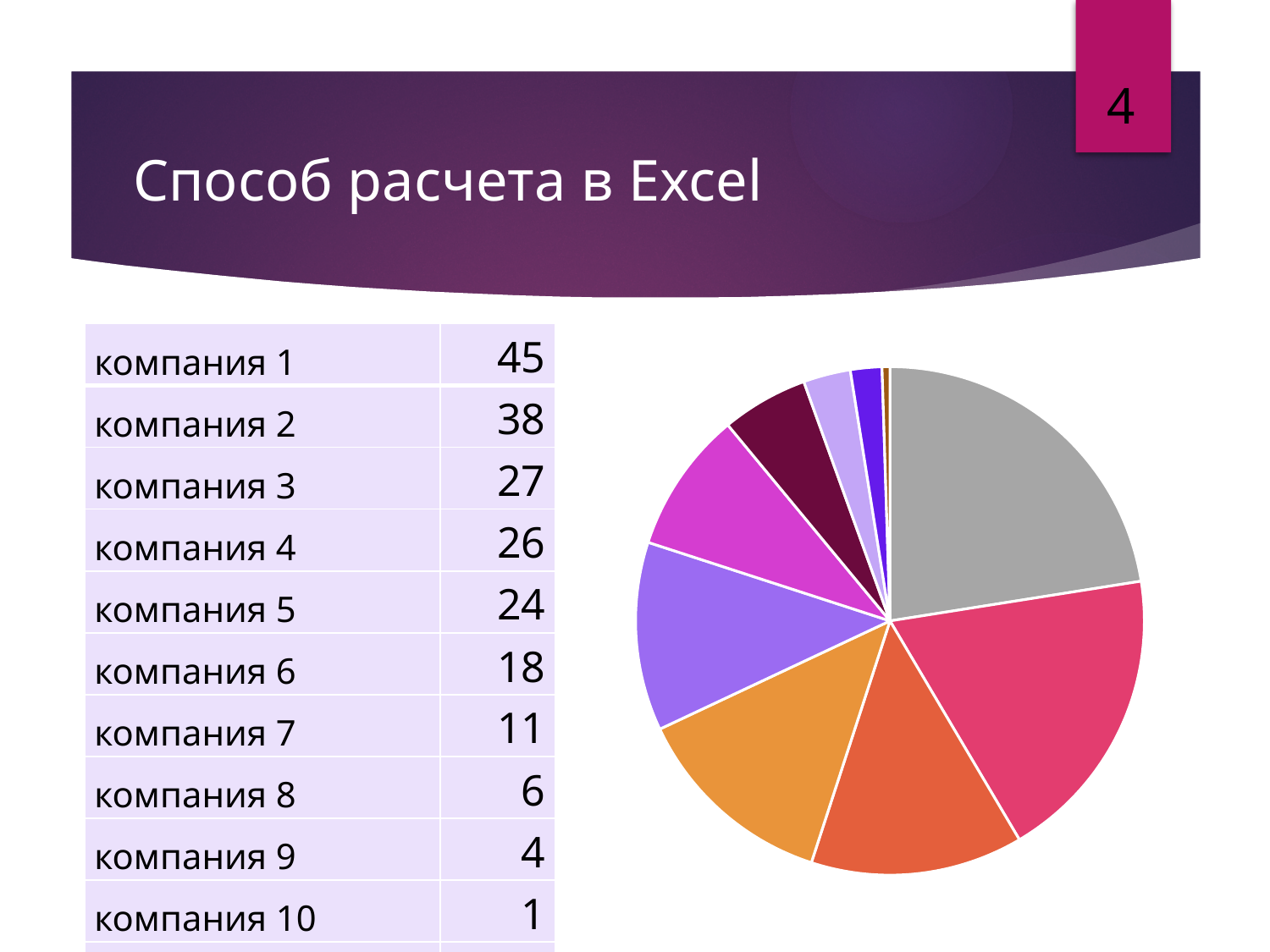
According to the table on the slide, what is the value for компания 3? 27 According to the table on the slide, what is the value for компания 7? 11 How many slices does the pie chart have? 10 What is the difference between the values for компания 1 and компания 2 in the table? 7 Which colour slice is the largest in the pie chart? gray Which is larger in the pie chart, the purple slice or the magenta slice? purple Which company in the table has the lowest value? компания 10 What kind of chart is shown on the slide? pie chart What is the total of all the company values listed in the table? 200 Which is larger in the pie chart, the gray slice or the pink slice? gray What share of the total do the values for компания 1 represent? 22.5% What is the title of the slide? Способ расчета в Excel